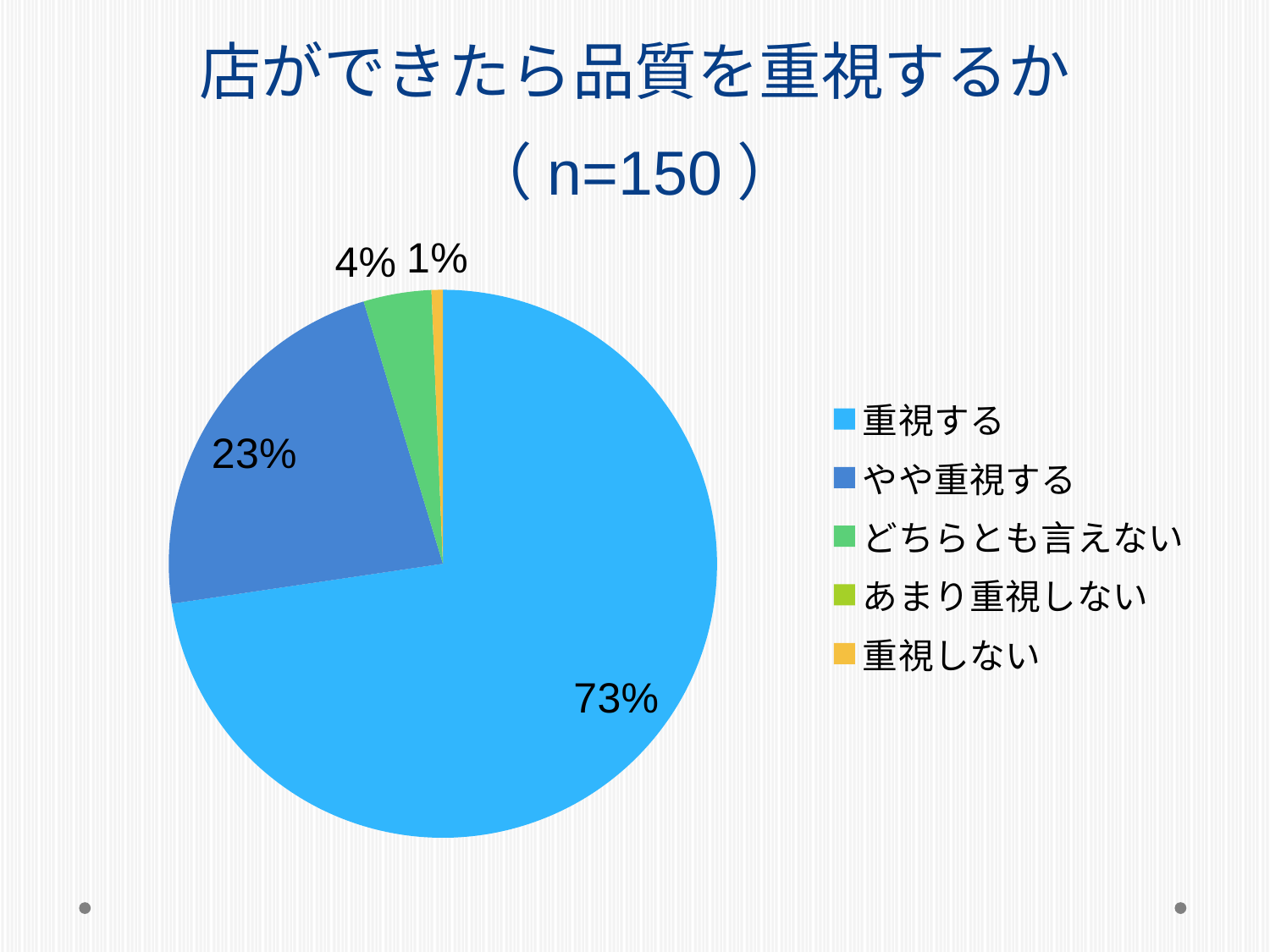
How many categories does the legend list? 5 What kind of chart is shown on the slide? Pie chart What is the difference in percentage points between 重視する and やや重視する? 50 What percentage is shown for どちらとも言えない? 4% What percentage of the pie chart is labelled for 重視する? 73% What is the combined percentage of 重視する and やや重視する? 96% Which slice is larger, やや重視する or どちらとも言えない? やや重視する What is the title of the chart? 店ができたら品質を重視するか（n=150） What is the smallest percentage label shown on the pie chart? 1% What percentage is shown for やや重視する? 23% What is the sample size (n) given in the chart title? 150 Which category has the largest slice of the pie chart? 重視する